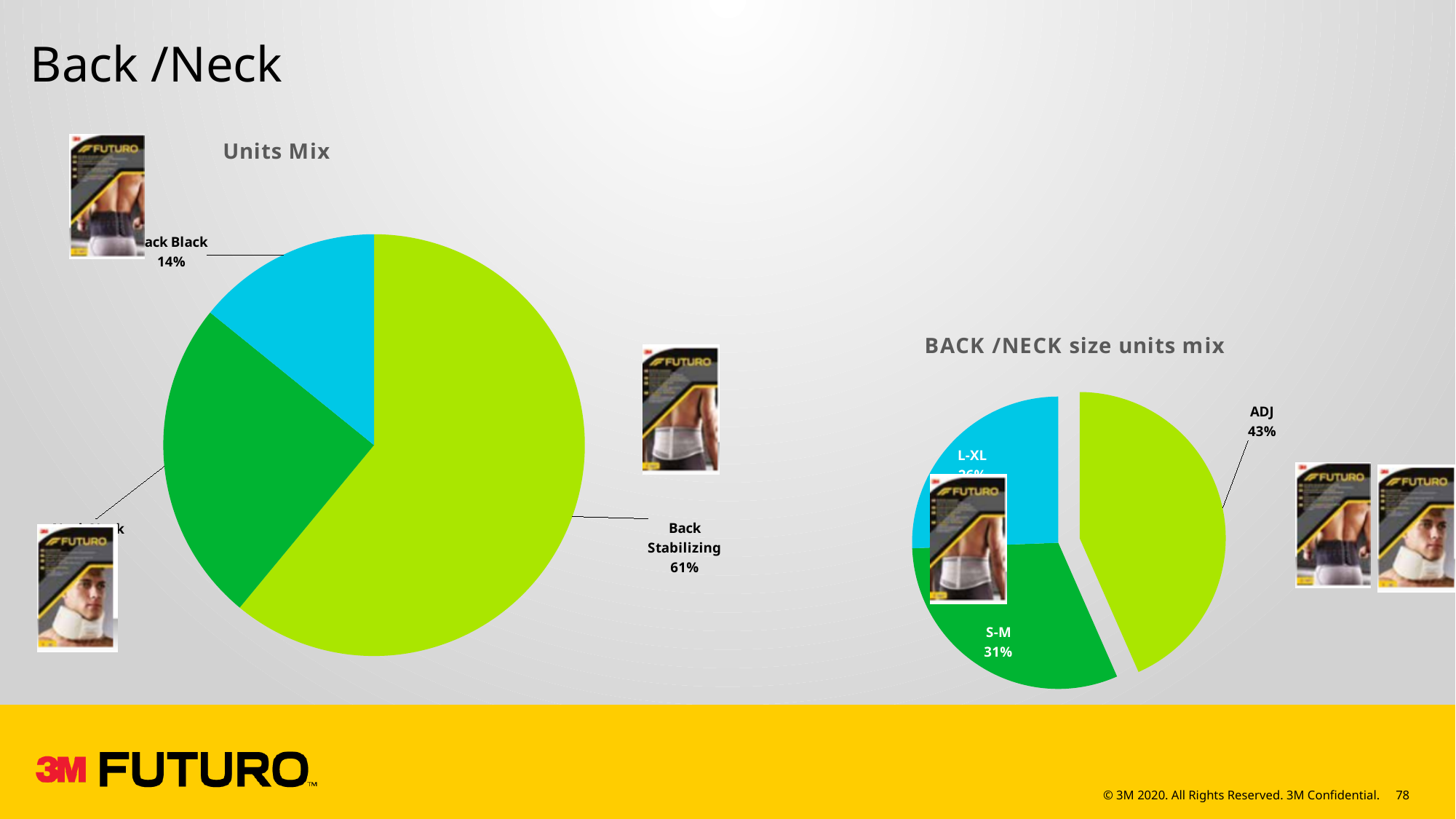
In the Units Mix chart, which category has the largest share? Back Stabilizing In the BACK /NECK size units mix chart, how many percentage points larger is ADJ than S-M? 12% What kind of chart is the Units Mix chart? Pie chart How many slices does the BACK /NECK size units mix pie chart have? 3 How many slices does the Units Mix pie chart have? 3 In the BACK /NECK size units mix chart, what is the share for S-M? 31% In the BACK /NECK size units mix chart, which size has the smallest share? L-XL In the BACK /NECK size units mix chart, what is the share for ADJ? 43% In the BACK /NECK size units mix chart, which is larger, ADJ or S-M? ADJ In the Units Mix chart, what share of units is Back Stabilizing? 61% In the BACK /NECK size units mix chart, which slice is pulled out from the rest of the pie? ADJ In the BACK /NECK size units mix chart, which size has the largest share? ADJ